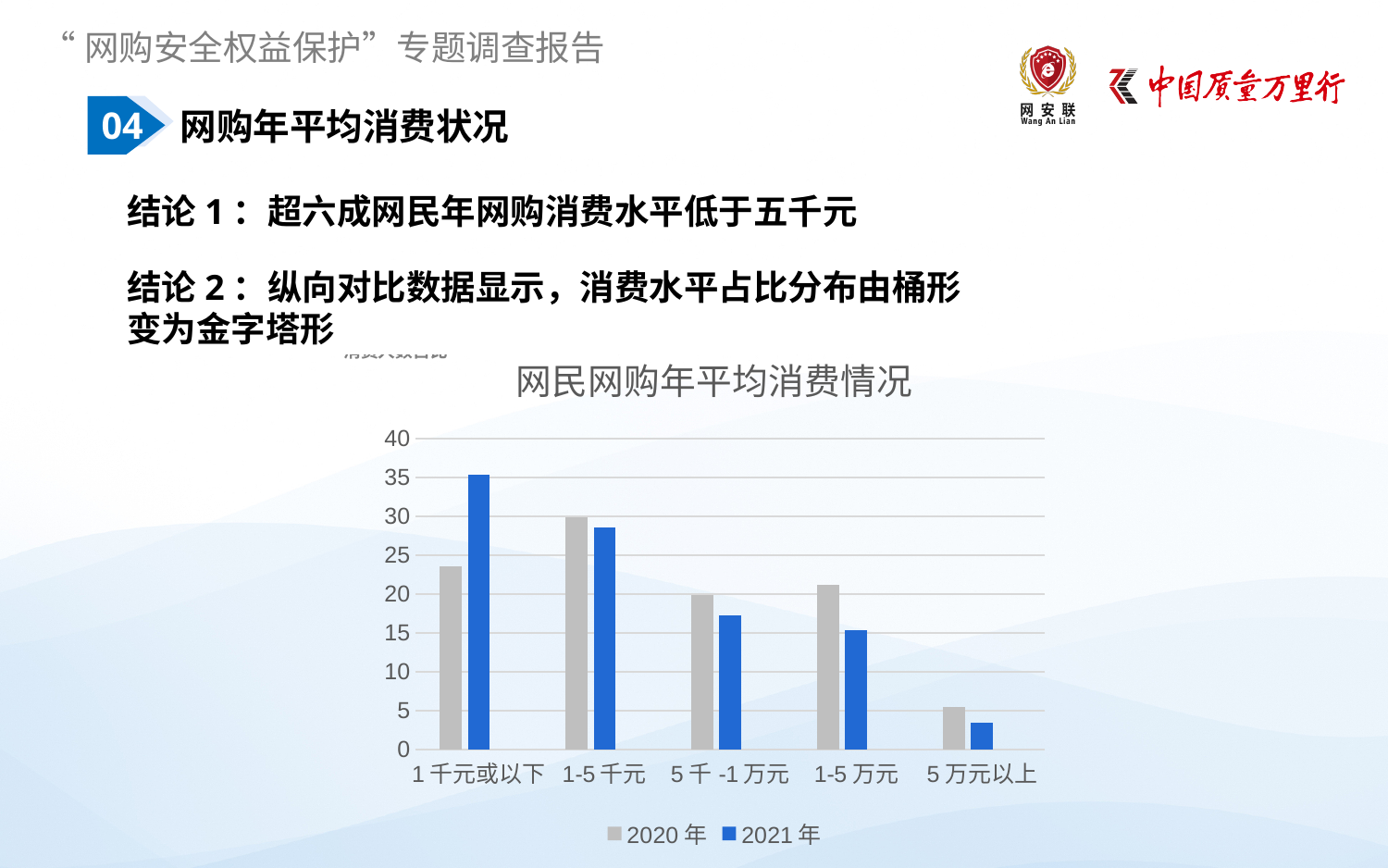
Which category has the lowest value for 2021年? 5万元以上 How many categories are shown on the x axis? 5 Is the value for 5万元以上 in 2021年 greater or less than 5? less Which category has the highest value for 2020年? 1-5千元 Is the value for 1-5万元 in 2021年 greater or less than 20? less For 1千元或以下, which series has the larger value, 2020年 or 2021年? 2021年 What is the title of the chart? 网民网购年平均消费情况 What kind of chart is shown on the slide? bar chart How many series does the legend list? 2 Is the value for 1千元或以下 in 2021年 greater or less than 30? greater Do the 2021年 values rise or fall moving from left to right along the x axis? fall Which category has the highest value for 2021年? 1千元或以下